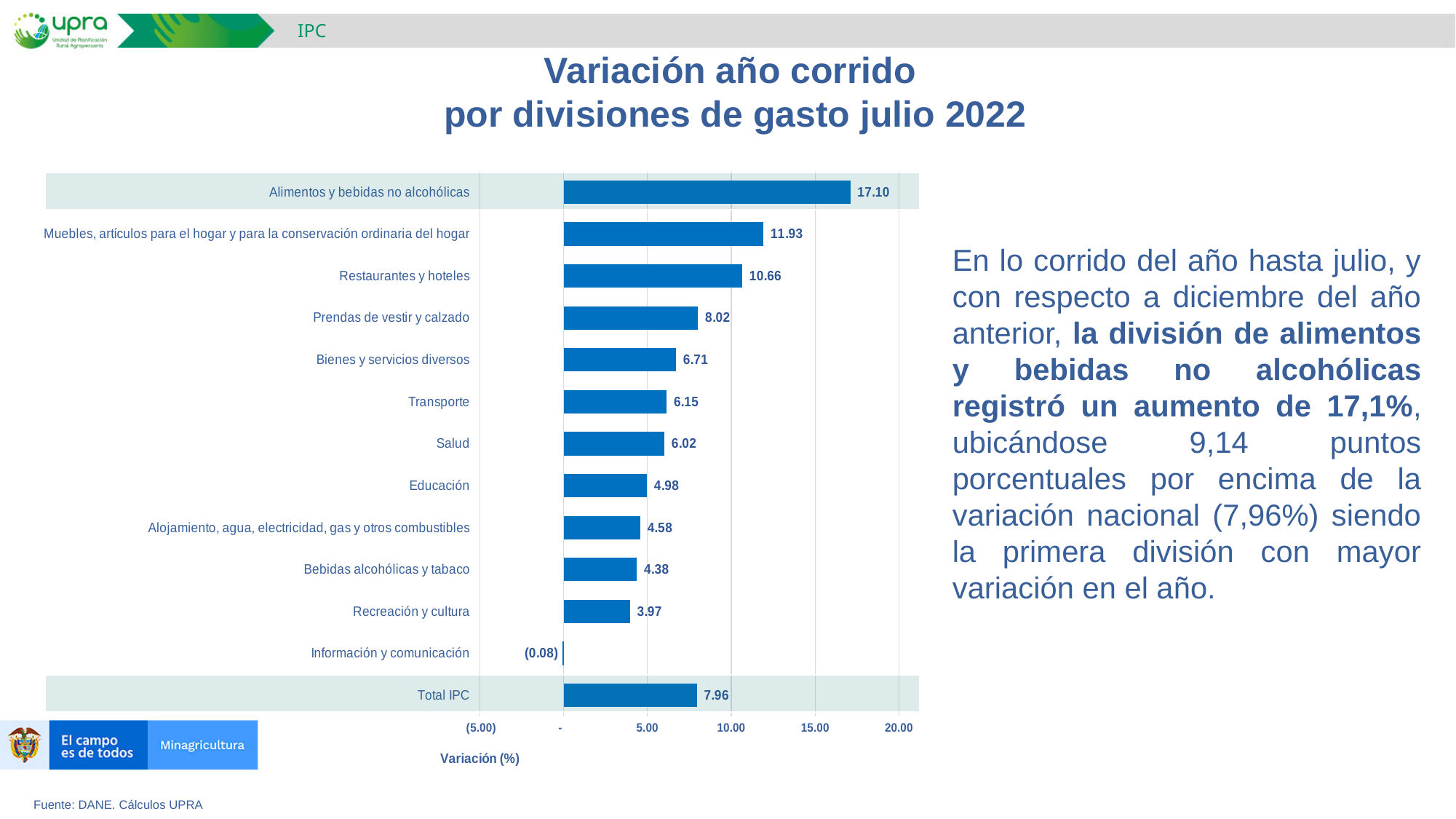
How many bars are shown in the chart? 13 What is the value for Total IPC? 7.96 What is the difference between Muebles, artículos para el hogar y para la conservación ordinaria del hogar and Restaurantes y hoteles? 1.27 Which category has the lowest value? Información y comunicación What kind of chart is shown on the slide? Bar chart What is the difference between Alimentos y bebidas no alcohólicas and Total IPC? 9.14 Which category has the highest value? Alimentos y bebidas no alcohólicas Which is larger, Educación or Recreación y cultura? Educación Is the value for Prendas de vestir y calzado greater or less than 10.00? less What is the value for Información y comunicación? (0.08) What is the value for Alimentos y bebidas no alcohólicas? 17.10 What is the value for Transporte? 6.15